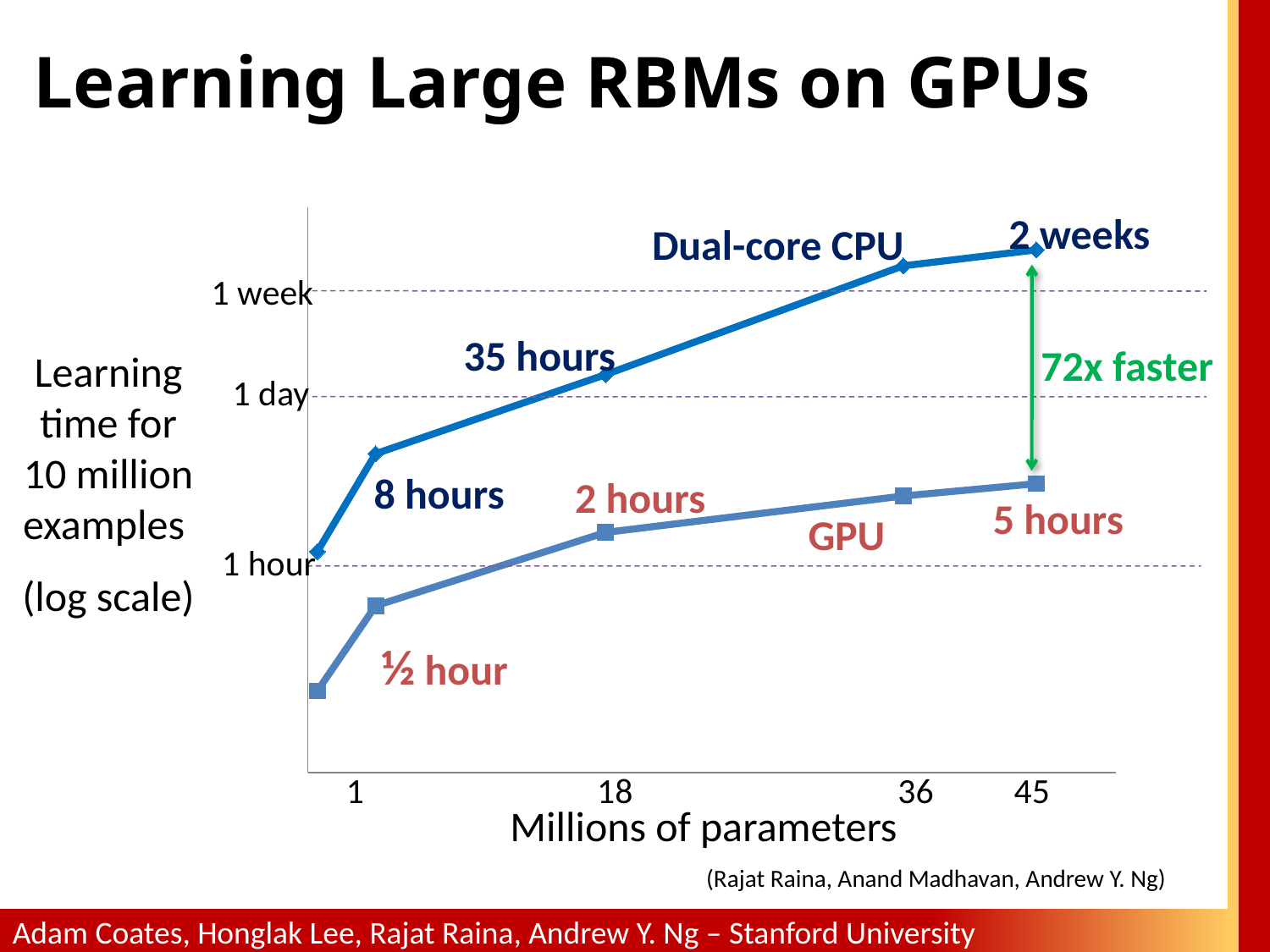
What speed-up does the green annotation on the chart state? 72x faster Is the Dual-core CPU learning time at 36 million parameters greater or less than 1 week? greater Which series has the higher learning time at 18 million parameters, Dual-core CPU or GPU? Dual-core CPU What is the labelled learning time for the GPU at 45 million parameters? 5 hours How many series are plotted on the chart? 2 What kind of chart is shown on the slide? line chart Is the GPU learning time at 36 million parameters greater or less than 1 day? less What is the labelled learning time for the GPU at 1 million parameters? ½ hour What is the labelled learning time for the Dual-core CPU at 45 million parameters? 2 weeks Do the learning times rise or fall as the number of parameters increases along the x axis? rise What is the labelled learning time for the GPU at 18 million parameters? 2 hours What is the labelled learning time for the Dual-core CPU at 18 million parameters? 35 hours